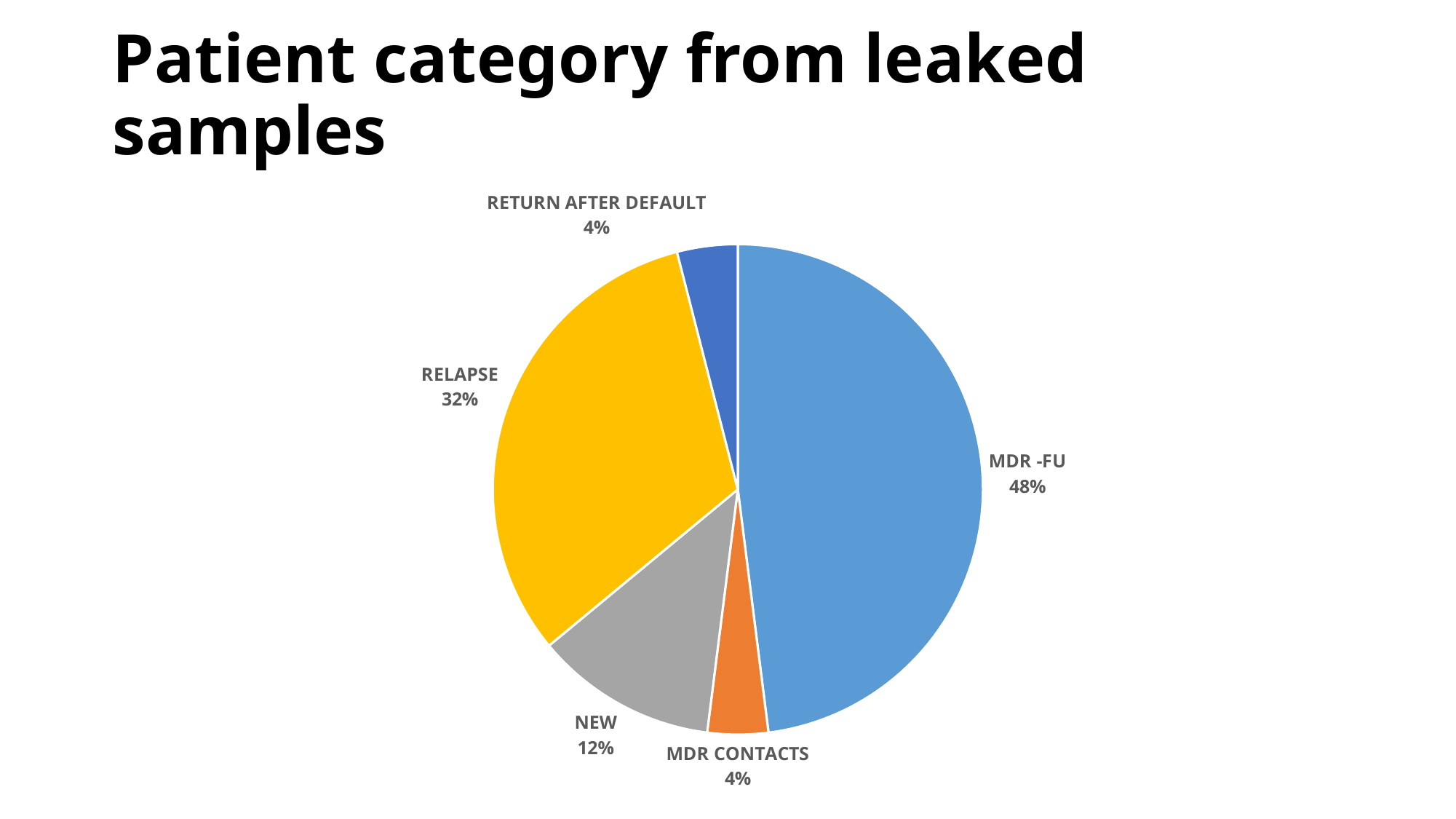
What is the value shown for RETURN AFTER DEFAULT? 4% What is the difference in percentage points between NEW and MDR CONTACTS? 8 What is the title of the chart on the slide? Patient category from leaked samples What share of the pie does MDR -FU represent? 48% What kind of chart is shown on the slide? Pie chart What is the value shown for NEW? 12% What is the difference in percentage points between MDR -FU and RELAPSE? 16 Which category has the largest share of the pie? MDR -FU How many categories are shown in the pie chart? 5 What is the value shown for MDR CONTACTS? 4% What is the value shown for RELAPSE? 32% Which is larger, the share for RELAPSE or the share for NEW? RELAPSE